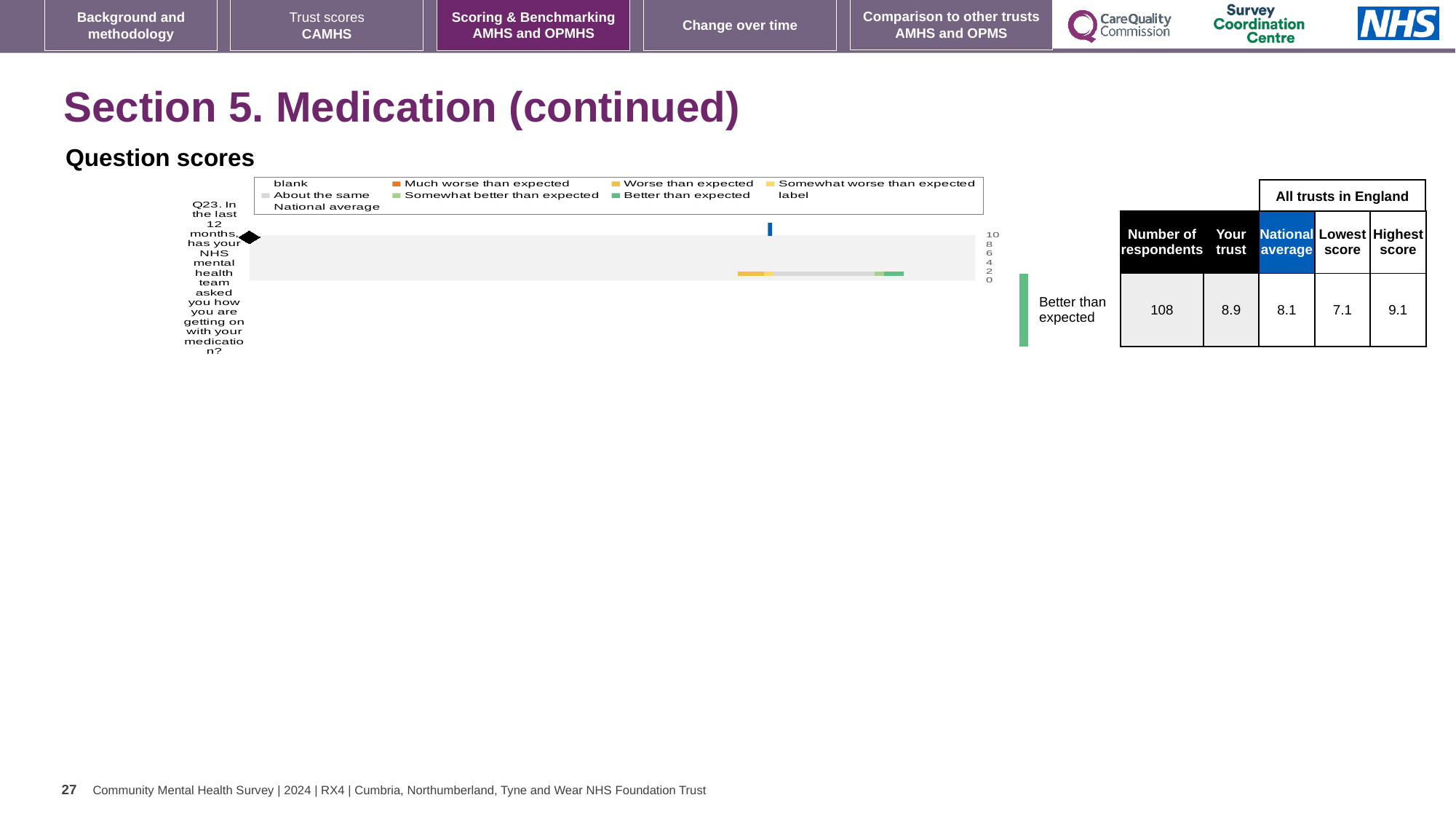
Which question is plotted in the chart? Q23. In the last 12 months, has your NHS mental health team asked you how you are getting on with your medication? What kind of chart is shown under 'Question scores'? bar chart According to the table beside the chart, what is the national average score for Q23? 8.1 According to the table beside the chart, what is the highest score among all trusts in England for Q23? 9.1 What is the difference between the 'Your trust' score and the national average for Q23? 0.8 How many respondents answered Q23, according to the table beside the chart? 108 According to the table beside the chart, what is the score for 'Your trust' on Q23? 8.9 How many questions (categories) are plotted in the chart? 1 Is the 'Your trust' score for Q23 higher or lower than the national average? higher What benchmark rating is shown next to the chart for Q23? Better than expected According to the table beside the chart, what is the lowest score among all trusts in England for Q23? 7.1 What colour does the legend use for 'Better than expected'? green